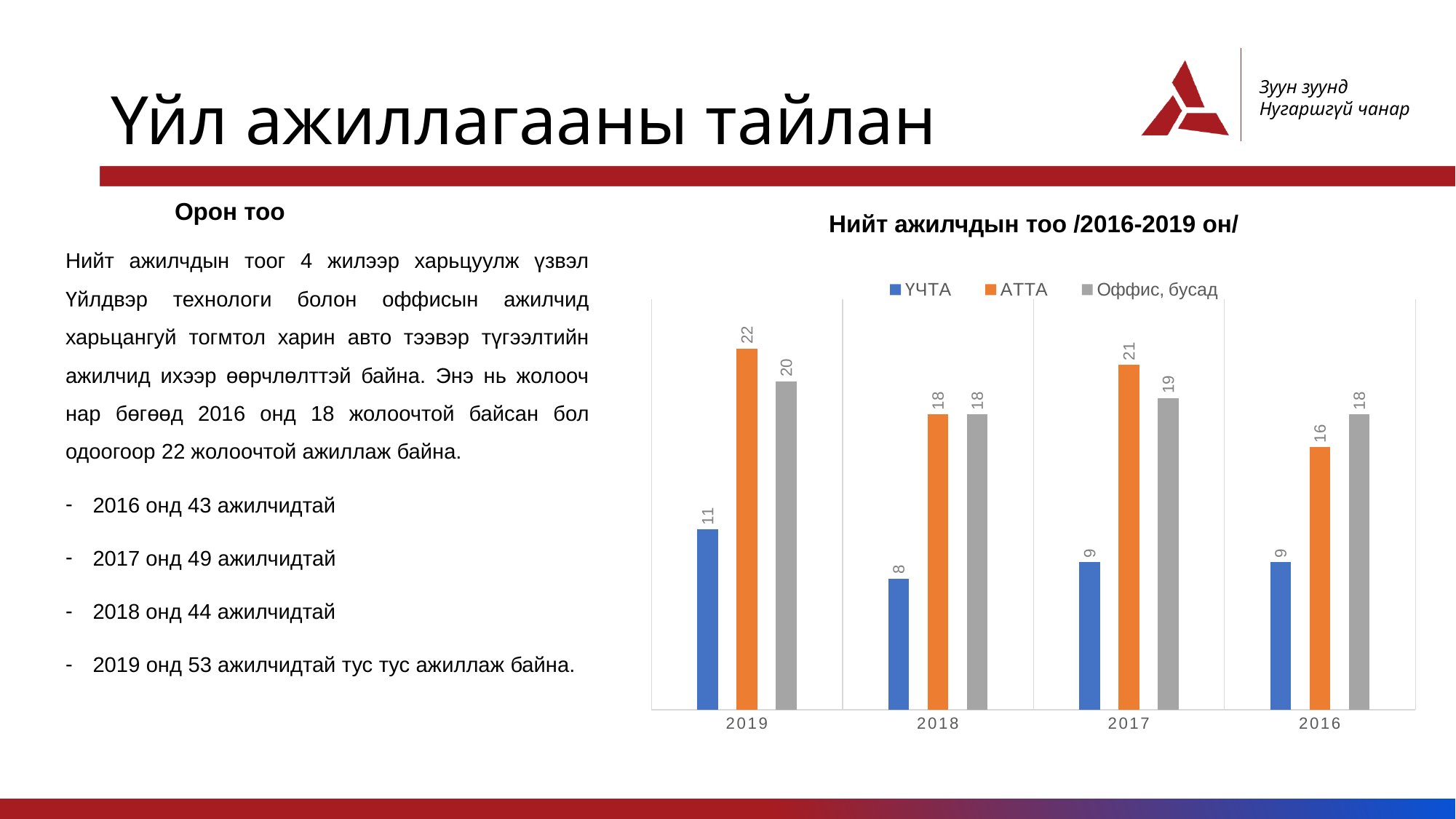
Which is larger in 2016, the АТТА value or the Оффис, бусад value? Оффис, бусад What is the difference between the АТТА value and the ҮЧТА value in 2017? 12 What is the title of the chart? Нийт ажилчдын тоо /2016-2019 он/ What is the value for АТТА in 2016? 16 How many year categories are shown on the x axis of the chart? 4 What type of chart is shown on the slide? bar chart What is the value for АТТА in 2019? 22 What is the value for Оффис, бусад in 2017? 19 In which year is the АТТА value lowest? 2016 What is the value for ҮЧТА in 2018? 8 How many series does the legend list in the chart? 3 In which year is the ҮЧТА value highest? 2019